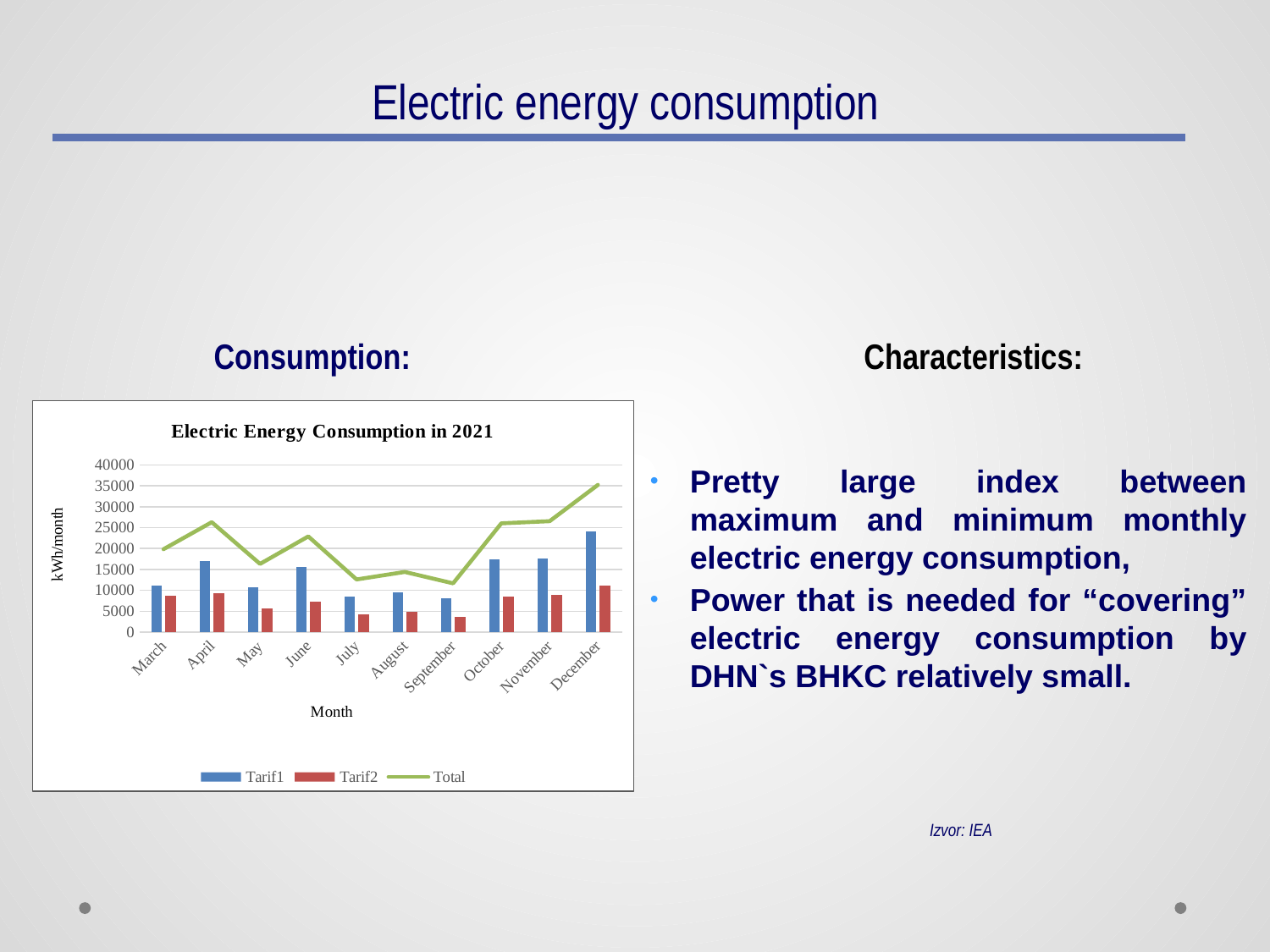
In March, which is larger, the Tarif1 value or the Tarif2 value? Tarif1 Which month has the highest Tarif2 value? December Is the Tarif1 value for December greater or less than 20000? greater How many series does the chart's legend list? 3 Which is larger, the Total value for April or the Total value for May? April Is the Total value for July greater or less than 15000? less Which month has the highest Total value? December Is the Total value for December greater or less than 30000? greater What kind of chart is shown on the slide? A bar chart with a line series What is the label on the chart's vertical axis? kWh/month Which month has the highest Tarif1 value? December How many months are shown on the x axis of the chart? 10